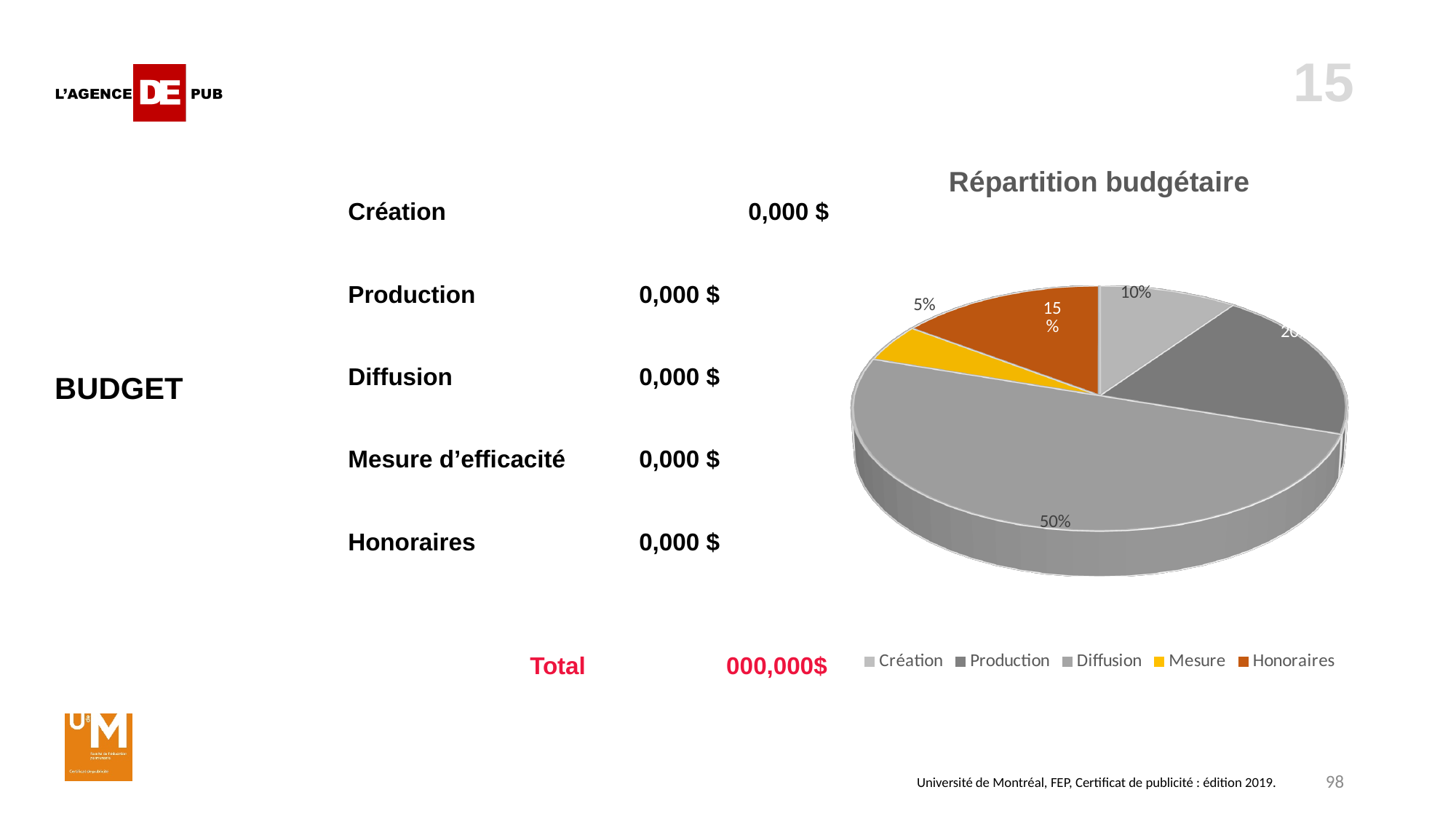
What is the title of the pie chart? Répartition budgétaire What share of the pie chart does Diffusion represent? 50% What is the difference in percentage points between the Diffusion slice and the Création slice? 40% What share of the pie chart does Mesure represent? 5% Which category has the largest slice in the pie chart? Diffusion What share of the pie chart does Honoraires represent? 15% What type of chart is shown on the slide? pie chart Which slice is larger in the pie chart, Honoraires or Création? Honoraires Which colour is used for the Mesure slice in the pie chart? yellow How many entries does the legend of the pie chart list? 5 Which category has the smallest slice in the pie chart? Mesure